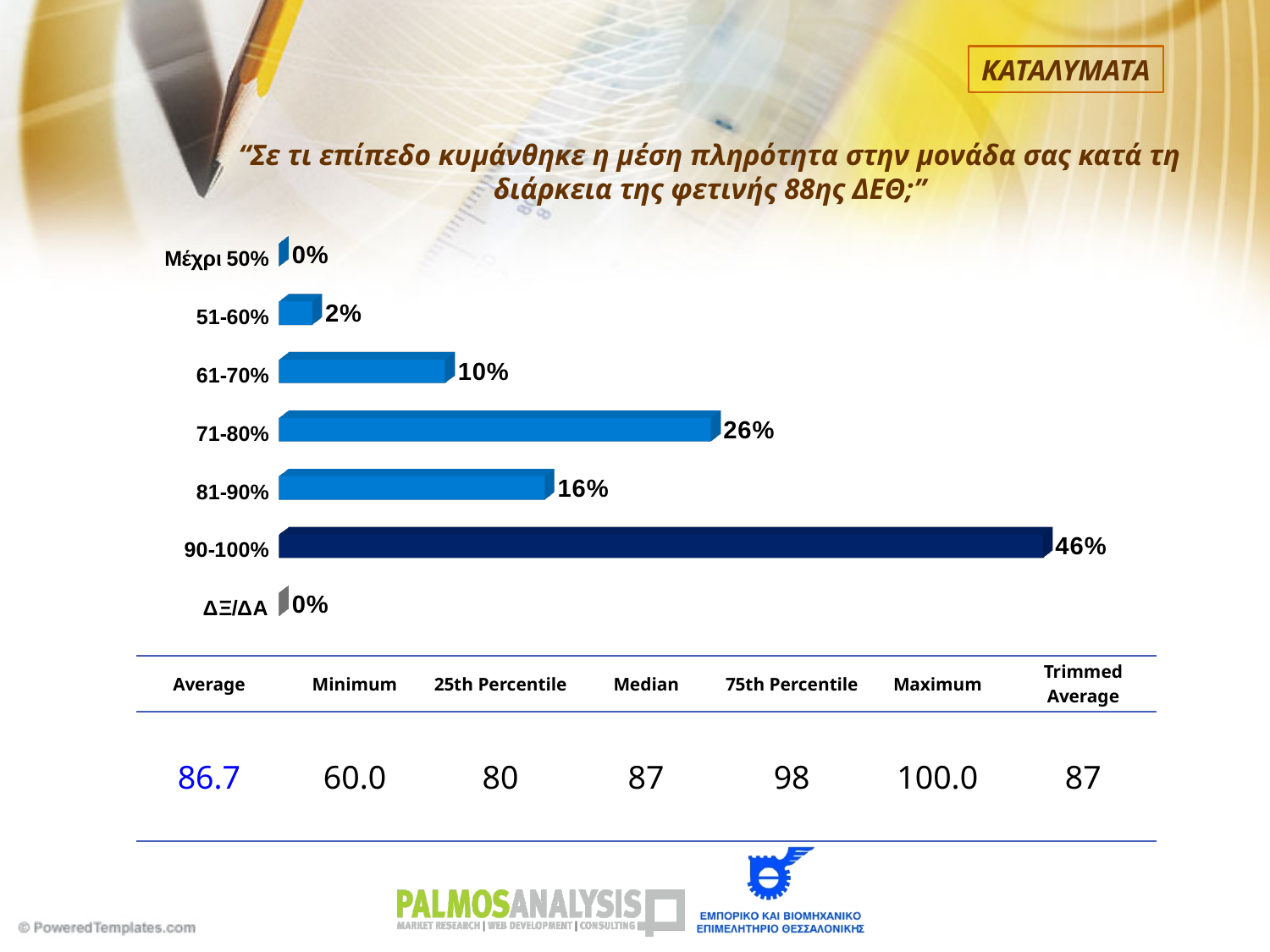
What is the value shown for the 71-80% category? 26% Which is larger, the value for 81-90% or the value for 61-70%? 81-90% What kind of chart is shown on the slide? Bar chart What percentage of respondents reported average occupancy of 90-100%? 46% What is the value shown for the ΔΞ/ΔΑ category? 0% What is the value shown for the 61-70% category? 10% How many categories are shown in the bar chart? 7 What is the value shown for the 51-60% category? 2% What is the difference between the values for 90-100% and 71-80%? 20% What is the value shown for the 81-90% category? 16% What is the difference between the values for 71-80% and 81-90%? 10% Which category has the highest value in the chart? 90-100%